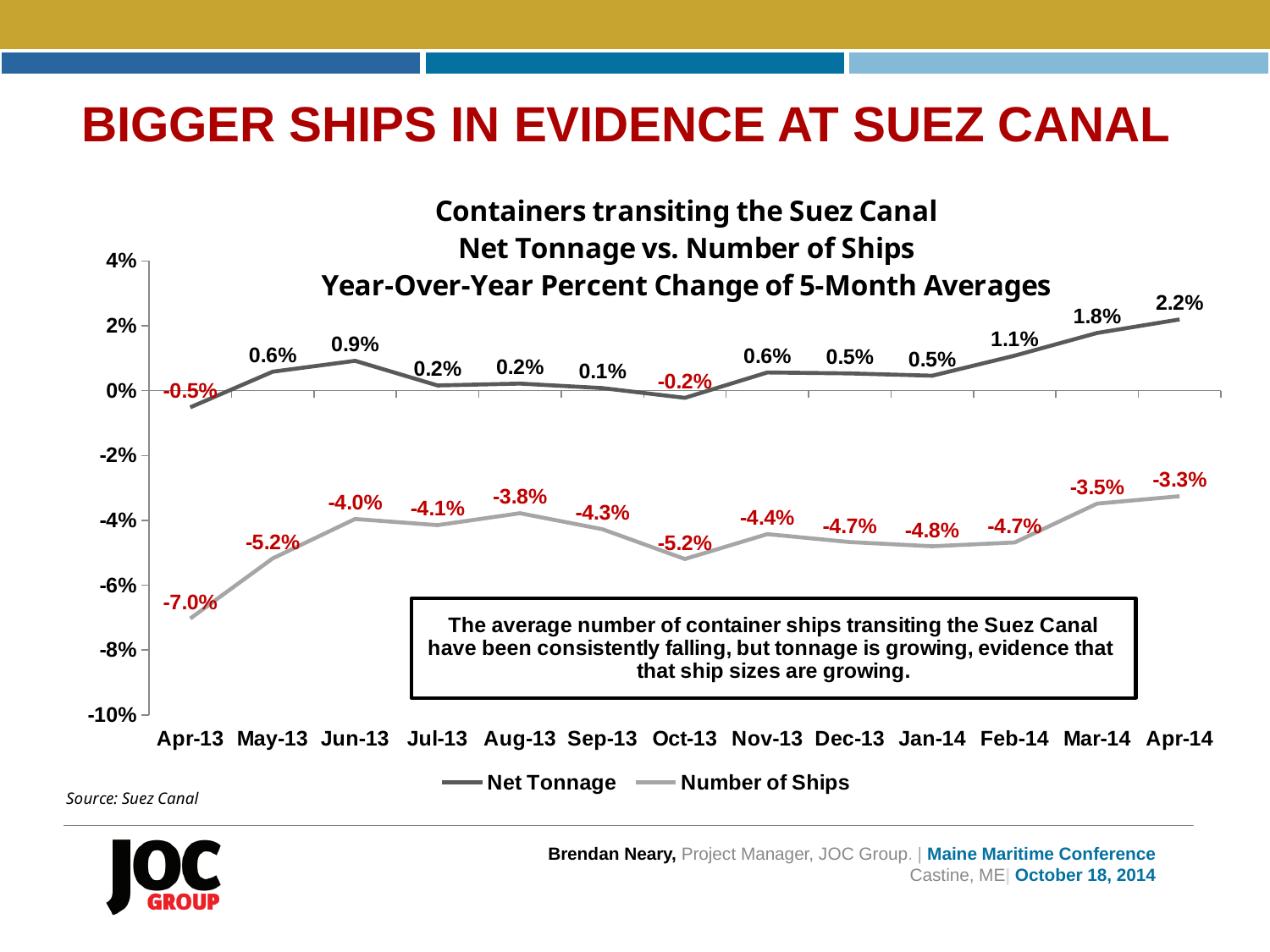
Which month has the lowest Number of Ships value? Apr-13 Does the Net Tonnage series rise or fall from Jan-14 to Apr-14? Rise Which month has the highest Net Tonnage value? Apr-14 How many months are plotted on the x axis? 13 What is the Net Tonnage value for Oct-13? -0.2% What is the difference between the Net Tonnage value and the Number of Ships value for Apr-14? 5.5 percentage points Which is larger, the Number of Ships value for Jun-13 or for Oct-13? Jun-13 What is the Net Tonnage value for Apr-14? 2.2% How many series does the legend list? 2 What type of chart is shown on the slide? Line chart What is the source cited for the chart? Suez Canal What is the Number of Ships value for Apr-13? -7.0%